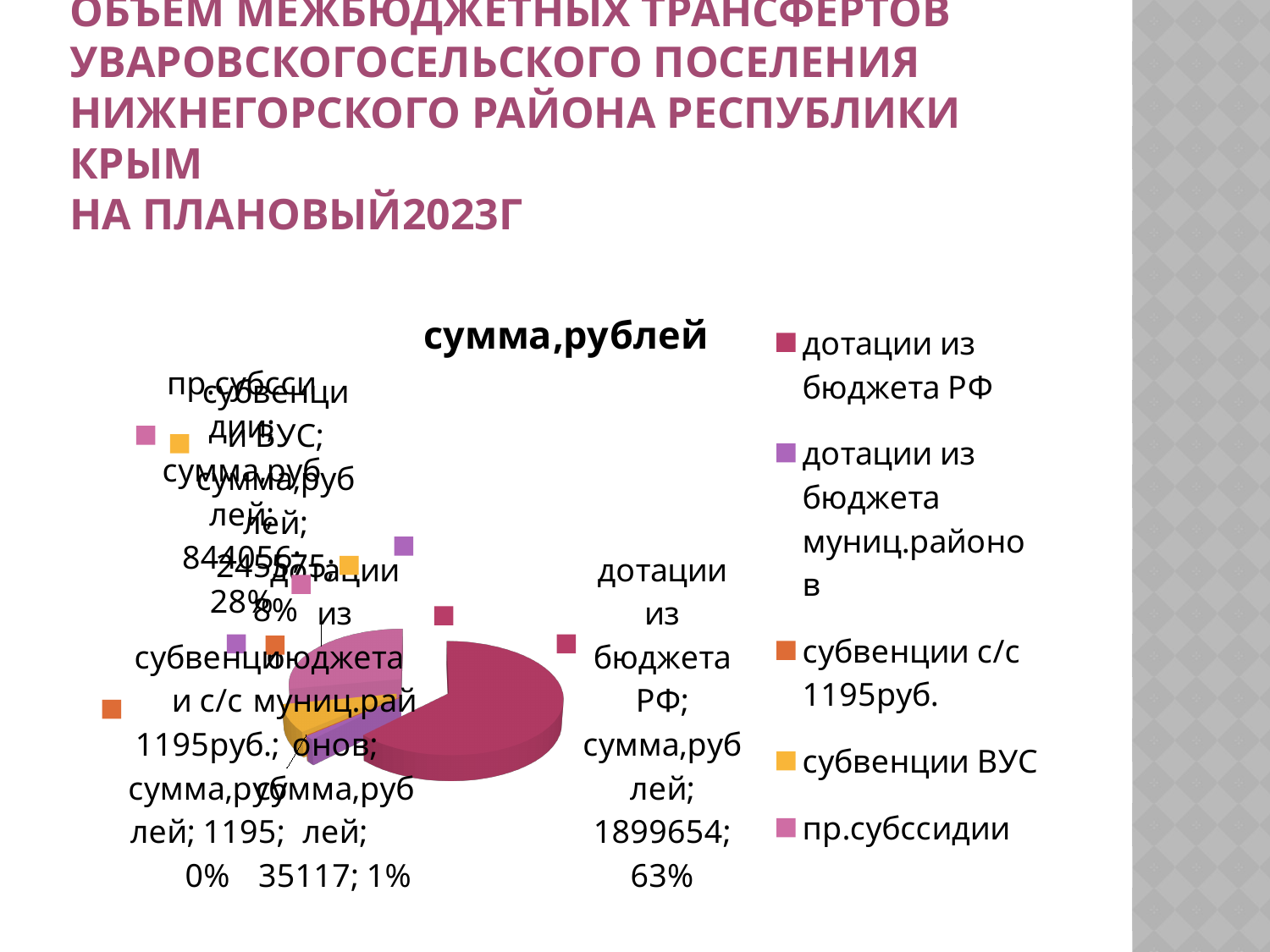
What kind of chart is shown on the slide? pie chart How many entries does the chart legend list? 5 Which category has the largest slice of the pie? дотации из бюджета РФ Which category has the smallest slice of the pie? субвенции с/с 1195руб. What is the value for субвенции с/с 1195руб.? 1195 What share of the pie does дотации из бюджета муниц.районов represent? 1% What is the value for дотации из бюджета РФ? 1899654 What is the difference between the values for дотации из бюджета РФ and дотации из бюджета муниц.районов? 1864537 How many slices does the pie chart have? 5 What is the title of the chart? сумма,рублей What share of the pie does дотации из бюджета РФ represent? 63% What is the value for дотации из бюджета муниц.районов? 35117